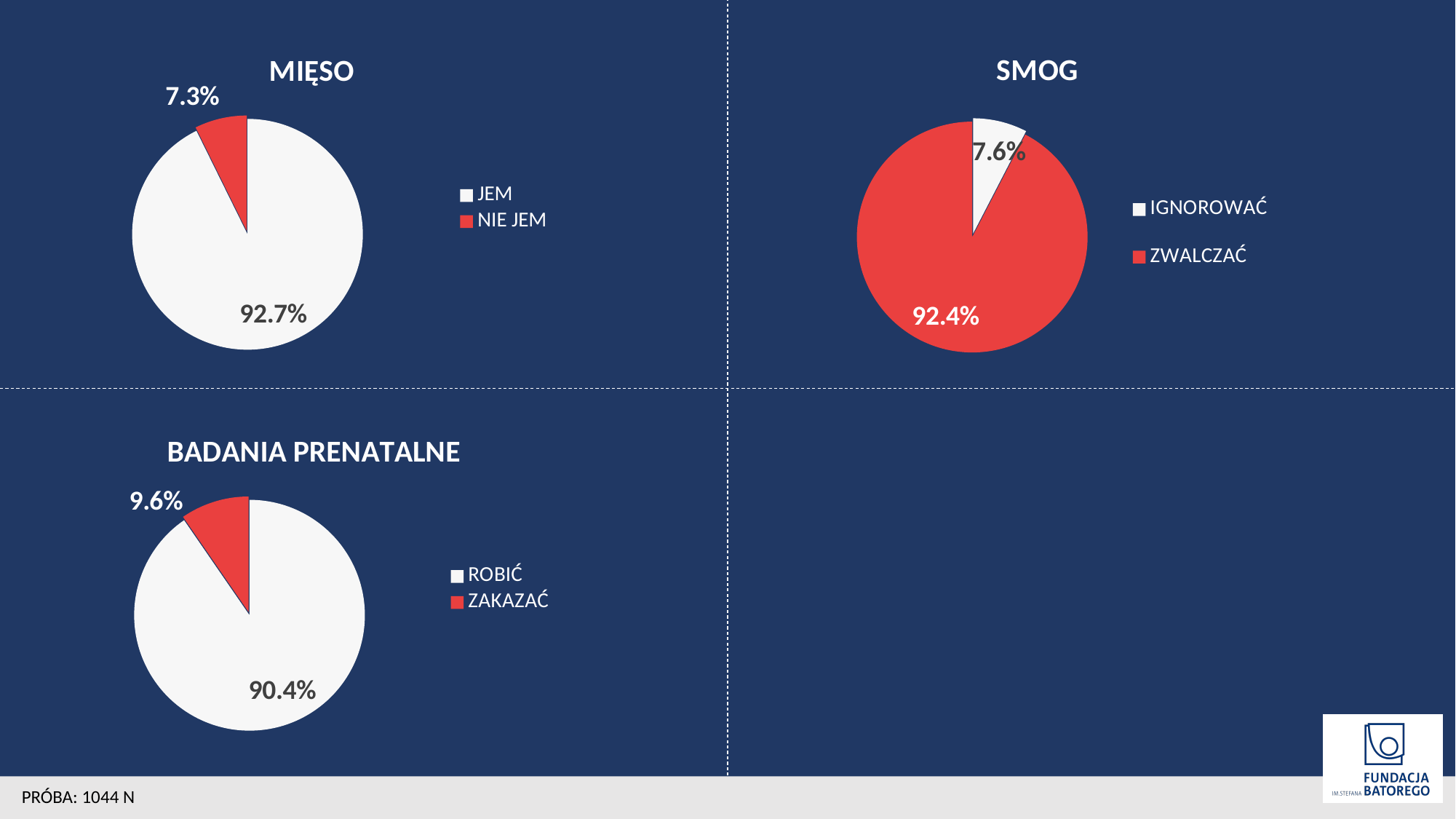
In the SMOG chart, which slice is the largest? ZWALCZAĆ What type of chart is the SMOG chart? Pie chart In the MIĘSO chart, what percentage is shown for NIE JEM? 7.3% In the BADANIA PRENATALNE chart, what percentage is shown for ZAKAZAĆ? 9.6% In the SMOG chart, what percentage is shown for IGNOROWAĆ? 7.6% In the BADANIA PRENATALNE chart, which slice is the smallest? ZAKAZAĆ In the BADANIA PRENATALNE chart, what percentage is shown for ROBIĆ? 90.4% In the SMOG chart, what percentage is shown for ZWALCZAĆ? 92.4% In the MIĘSO chart, what is the difference between the JEM and NIE JEM percentages? 85.4% How many entries does the legend of the BADANIA PRENATALNE chart list? 2 Which is larger: the NIE JEM slice in the MIĘSO chart or the ZAKAZAĆ slice in the BADANIA PRENATALNE chart? ZAKAZAĆ In the MIĘSO chart, what percentage is shown for JEM? 92.7%